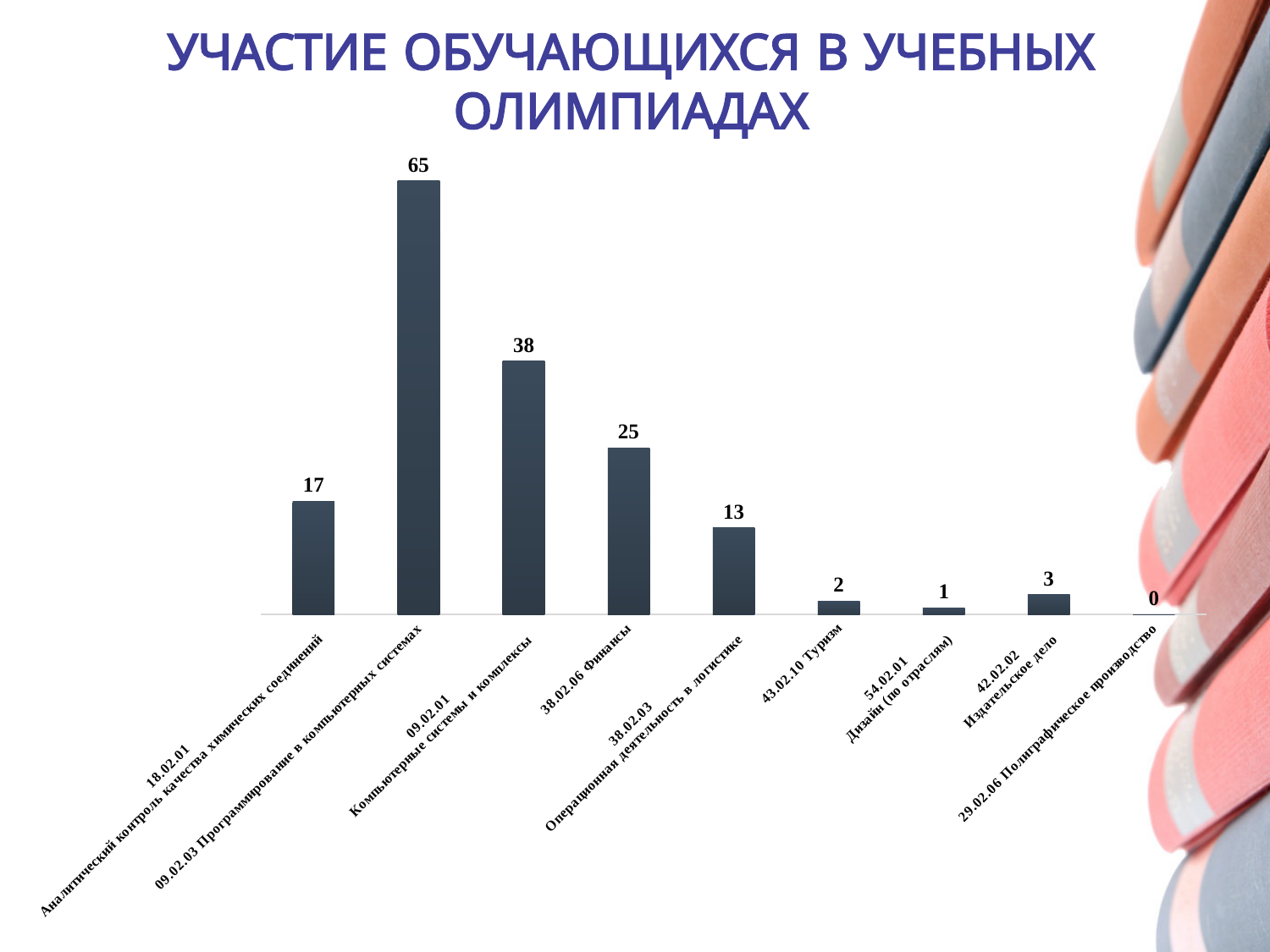
What is the value for 09.02.03 Программирование в компьютерных системах? 65 Which is larger, the value for 38.02.06 Финансы or the value for 09.02.01 Компьютерные системы и комплексы? 09.02.01 Компьютерные системы и комплексы What is the value for 38.02.06 Финансы? 25 What kind of chart is shown on the slide? Bar chart What is the difference between the values for 09.02.03 Программирование в компьютерных системах and 09.02.01 Компьютерные системы и комплексы? 27 What is the value for 29.02.06 Полиграфическое производство? 0 What is the title of the chart on the slide? УЧАСТИЕ ОБУЧАЮЩИХСЯ В УЧЕБНЫХ ОЛИМПИАДАХ Which category has the highest value? 09.02.03 Программирование в компьютерных системах How many categories are shown in the chart? 9 What is the value for 54.02.01 Дизайн (по отраслям)? 1 What is the difference between the values for 18.02.01 Аналитический контроль качества химических соединений and 38.02.03 Операционная деятельность в логистике? 4 Which category has the lowest value? 29.02.06 Полиграфическое производство